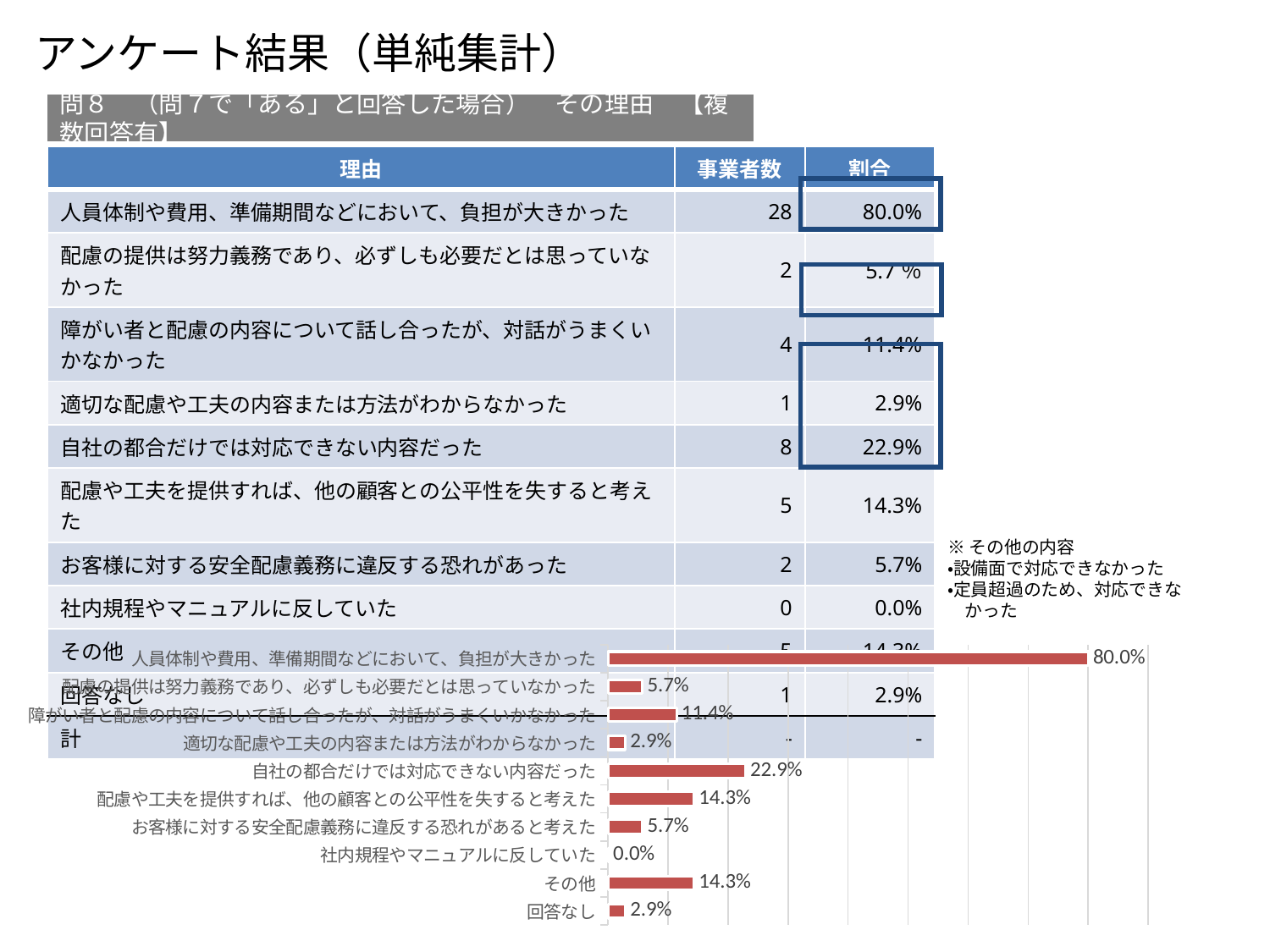
Which is larger in the bar chart: the value for 自社の都合だけでは対応できない内容だった or the value for 配慮や工夫を提供すれば、他の顧客との公平性を失すると考えた? 自社の都合だけでは対応できない内容だった What type of chart is shown on the slide? bar chart What is the value for 人員体制や費用、準備期間などにおいて、負担が大きかった in the bar chart? 80.0% What is the difference between the values for 人員体制や費用、準備期間などにおいて、負担が大きかった and 自社の都合だけでは対応できない内容だった in the bar chart? 57.1% What is the value for 回答なし in the bar chart? 2.9% Which category has the lowest value in the bar chart? 社内規程やマニュアルに反していた What is the value for 自社の都合だけでは対応できない内容だった in the bar chart? 22.9% Which category has the highest value in the bar chart? 人員体制や費用、準備期間などにおいて、負担が大きかった What is the value for 障がい者と配慮の内容について話し合ったが、対話がうまくいかなかった in the bar chart? 11.4% What is the difference between the values for 障がい者と配慮の内容について話し合ったが、対話がうまくいかなかった and 適切な配慮や工夫の内容または方法がわからなかった in the bar chart? 8.5% How many categories does the bar chart show? 10 What is the value for その他 in the bar chart? 14.3%